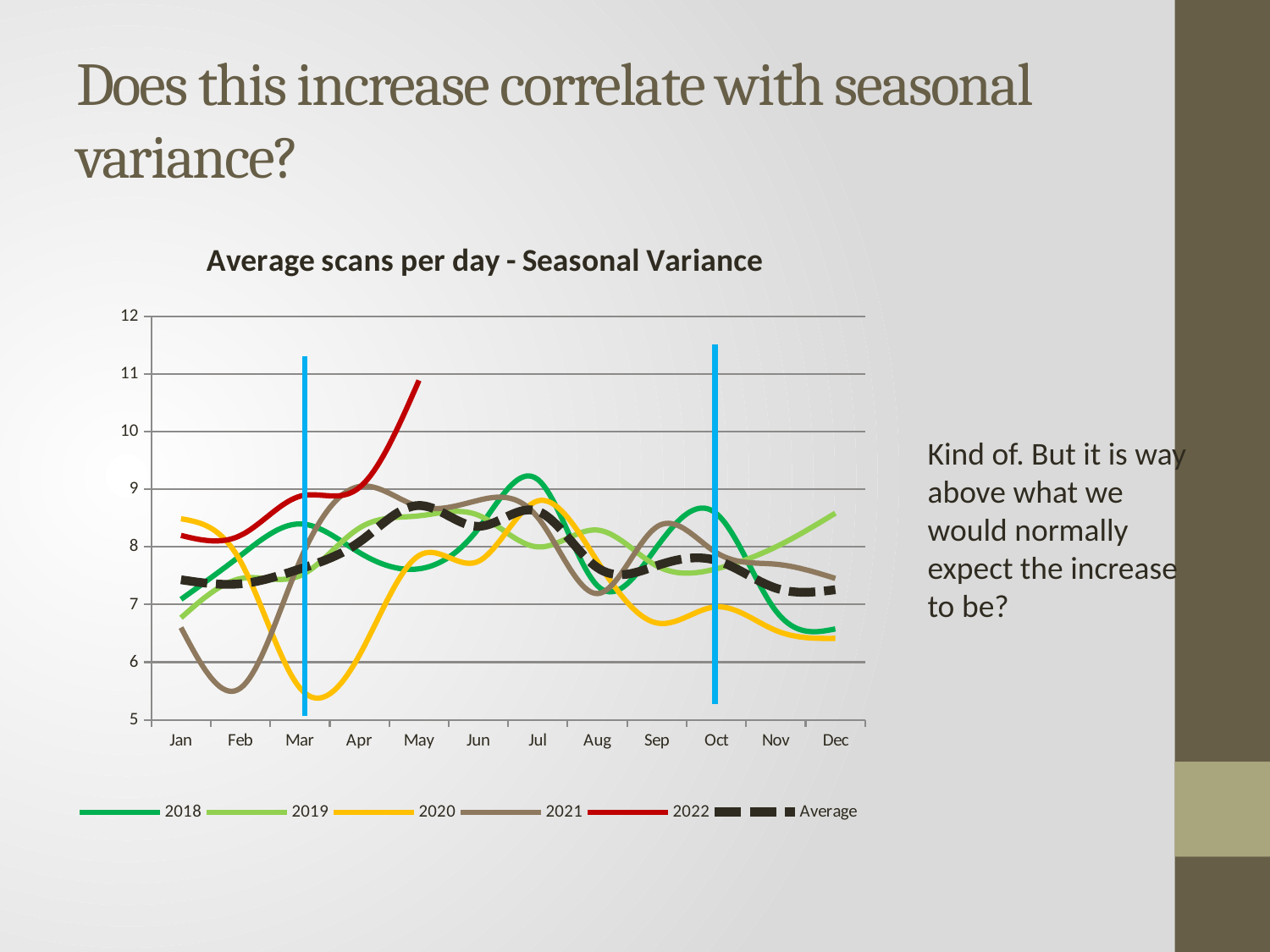
Is the value for 2019 in Dec greater or less than 8? greater What kind of chart is shown on the slide? line chart Is the value for 2020 in Dec greater or less than 7? less Which series is drawn as a dashed line? Average Does the 2022 line rise or fall from Jan to May? rise How many series does the legend list? 6 How many months are shown along the x axis? 12 Is the value for 2022 in May greater or less than 10? greater What is the title of the chart? Average scans per day - Seasonal Variance Which series has the highest value in May? 2022